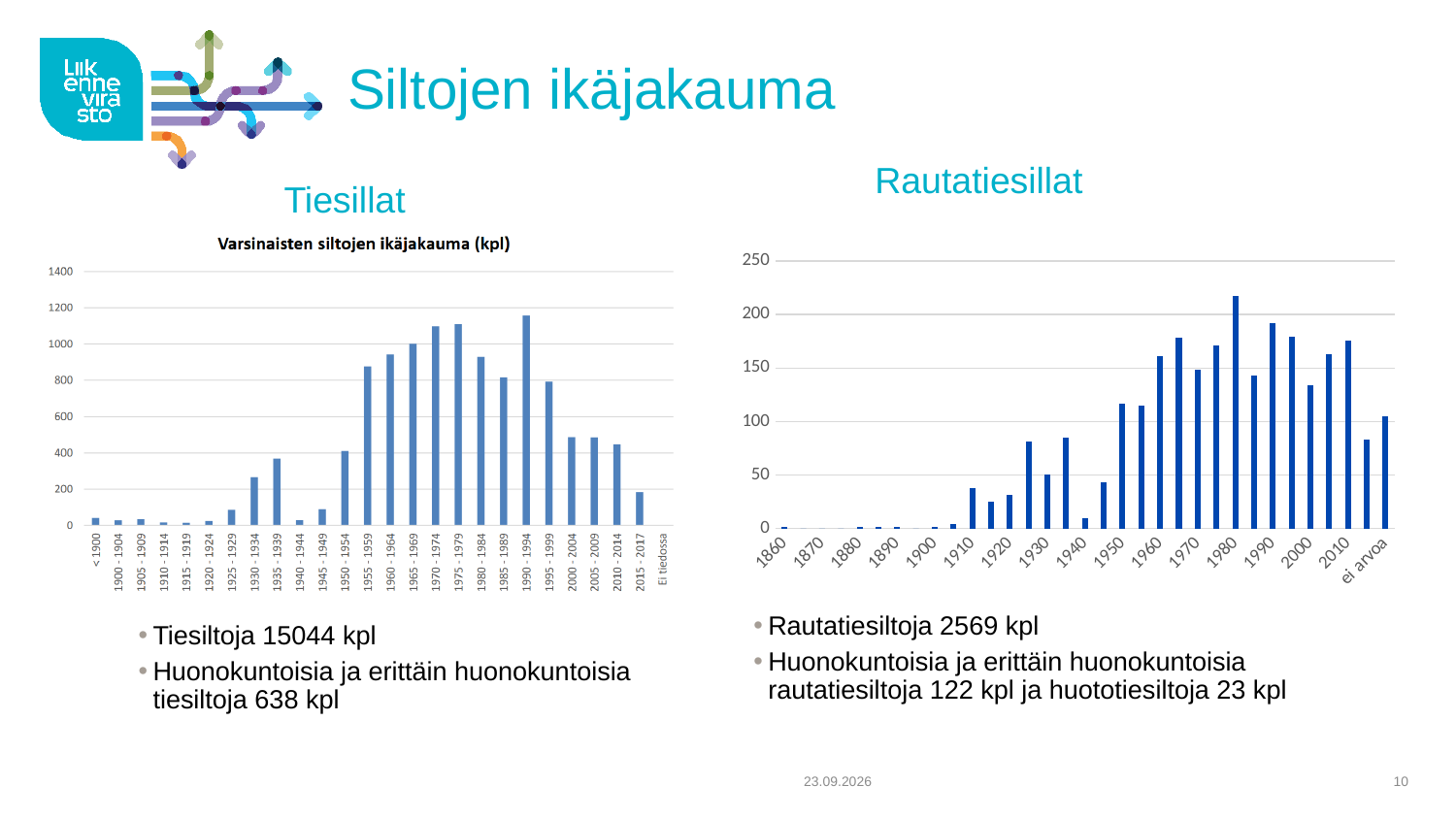
In the left chart 'Varsinaisten siltojen ikäjakauma (kpl)', which is larger, the value for 1975 - 1979 or the value for 2000 - 2004? 1975 - 1979 In the left chart 'Varsinaisten siltojen ikäjakauma (kpl)', which category has the highest value? 1990 - 1994 In the left chart 'Varsinaisten siltojen ikäjakauma (kpl)', is the value for 2015 - 2017 greater or less than 200? less In the left chart 'Varsinaisten siltojen ikäjakauma (kpl)', how many categories are shown on the x axis? 26 In the right chart under 'Rautatiesillat', do the values generally rise or fall from 1900 to 1980? rise In the right chart under 'Rautatiesillat', is the value for 1910 greater or less than 50? less What kind of chart is the left chart titled 'Varsinaisten siltojen ikäjakauma (kpl)'? bar chart What kind of chart is the right chart under the heading 'Rautatiesillat'? bar chart In the right chart under 'Rautatiesillat', is the value for the tallest bar (around 1980) greater or less than 200? greater In the right chart under 'Rautatiesillat', which is larger, the value for 1980 or the value for 1990? 1980